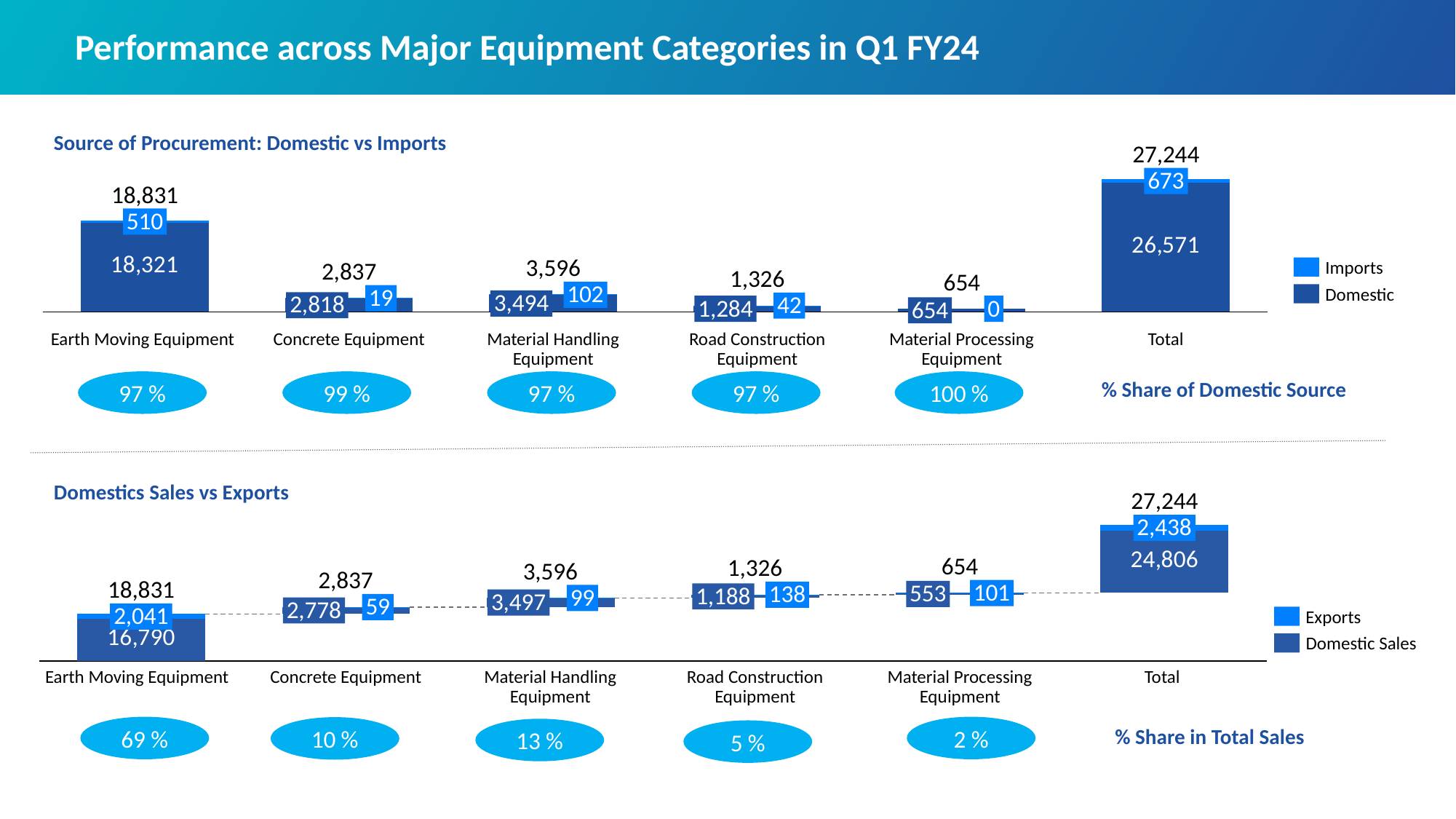
In the 'Source of Procurement: Domestic vs Imports' chart, how many series does the legend list? 2 What type of chart is the 'Domestics Sales vs Exports' chart? Stacked bar chart In the 'Source of Procurement: Domestic vs Imports' chart, which equipment category (excluding Total) has the lowest combined value? Material Processing Equipment In the 'Source of Procurement: Domestic vs Imports' chart, what is the total shown above the Concrete Equipment bar? 2,837 How many equipment categories, including Total, are shown on the x axis of the 'Domestics Sales vs Exports' chart? 6 In the 'Source of Procurement: Domestic vs Imports' chart, what is the Imports value for Material Handling Equipment? 102 In the 'Domestics Sales vs Exports' chart, which is larger: the Exports value for Concrete Equipment or the Exports value for Material Processing Equipment? Material Processing Equipment In the 'Domestics Sales vs Exports' chart, what is the difference between Domestic Sales and Exports for Total? 22,368 In the 'Source of Procurement: Domestic vs Imports' chart, what is the difference between the Imports values for Total and Earth Moving Equipment? 163 In the 'Domestics Sales vs Exports' chart, what is the Domestic Sales value for Earth Moving Equipment? 16,790 In the 'Source of Procurement: Domestic vs Imports' chart, what is the Domestic value for Earth Moving Equipment? 18,321 In the 'Domestics Sales vs Exports' chart, what is the Exports value for Road Construction Equipment? 138